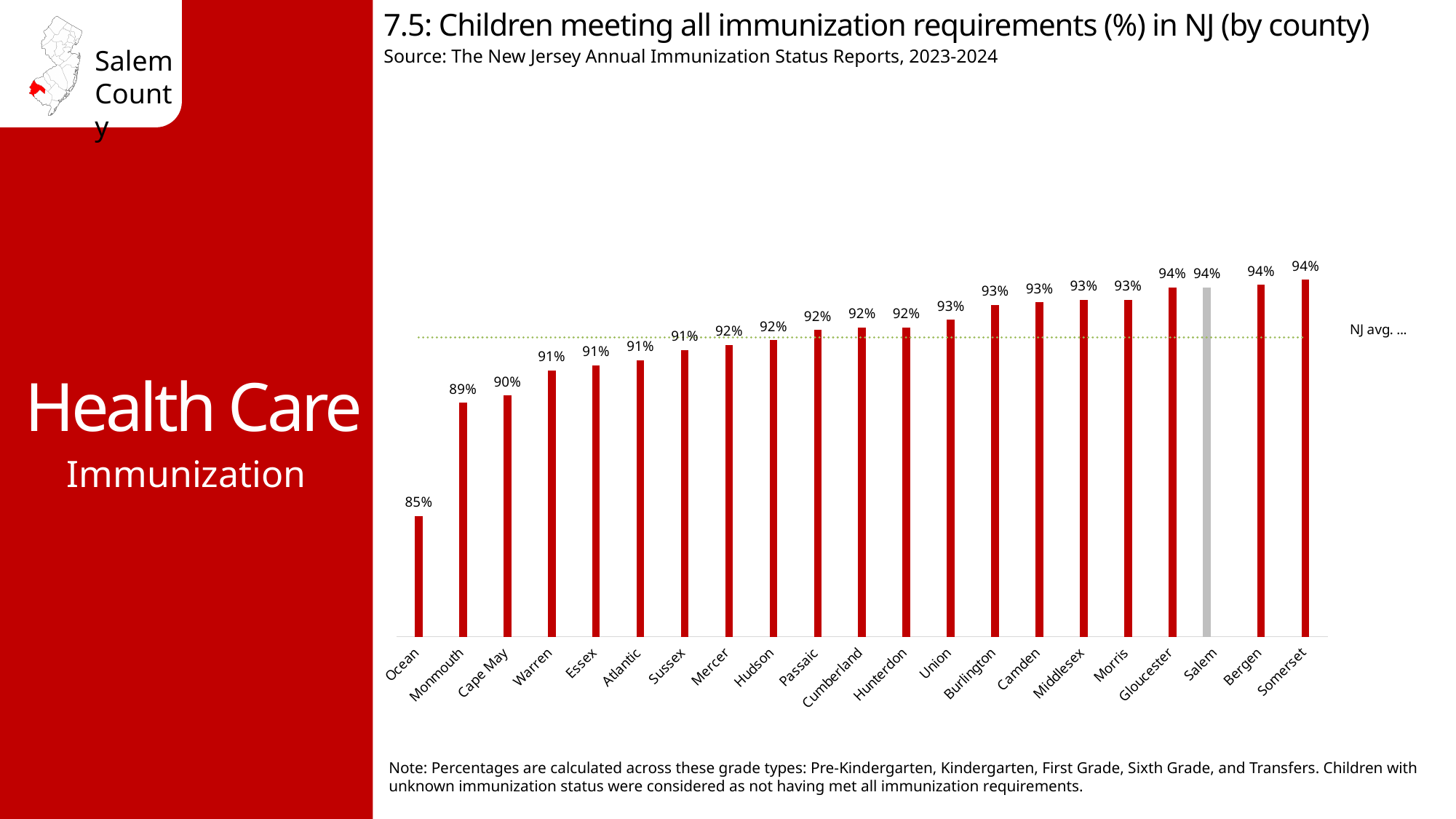
What is the value shown for Hunterdon County? 92% What is the value shown for Ocean County? 85% What is the value shown for Monmouth County? 89% What percentage of children in Salem County met all immunization requirements? 94% Do the values generally rise or fall moving from left to right along the x axis? Rise Which has a higher value, Ocean County or Cape May County? Cape May What is the difference in percentage points between Salem County and Monmouth County? 5 percentage points Which county has the lowest percentage of children meeting all immunization requirements? Ocean What kind of chart is shown on the slide? Bar chart What is the value shown for Cape May County? 90% How many counties are shown on the chart? 21 What is the difference in percentage points between Somerset County and Ocean County? 9 percentage points